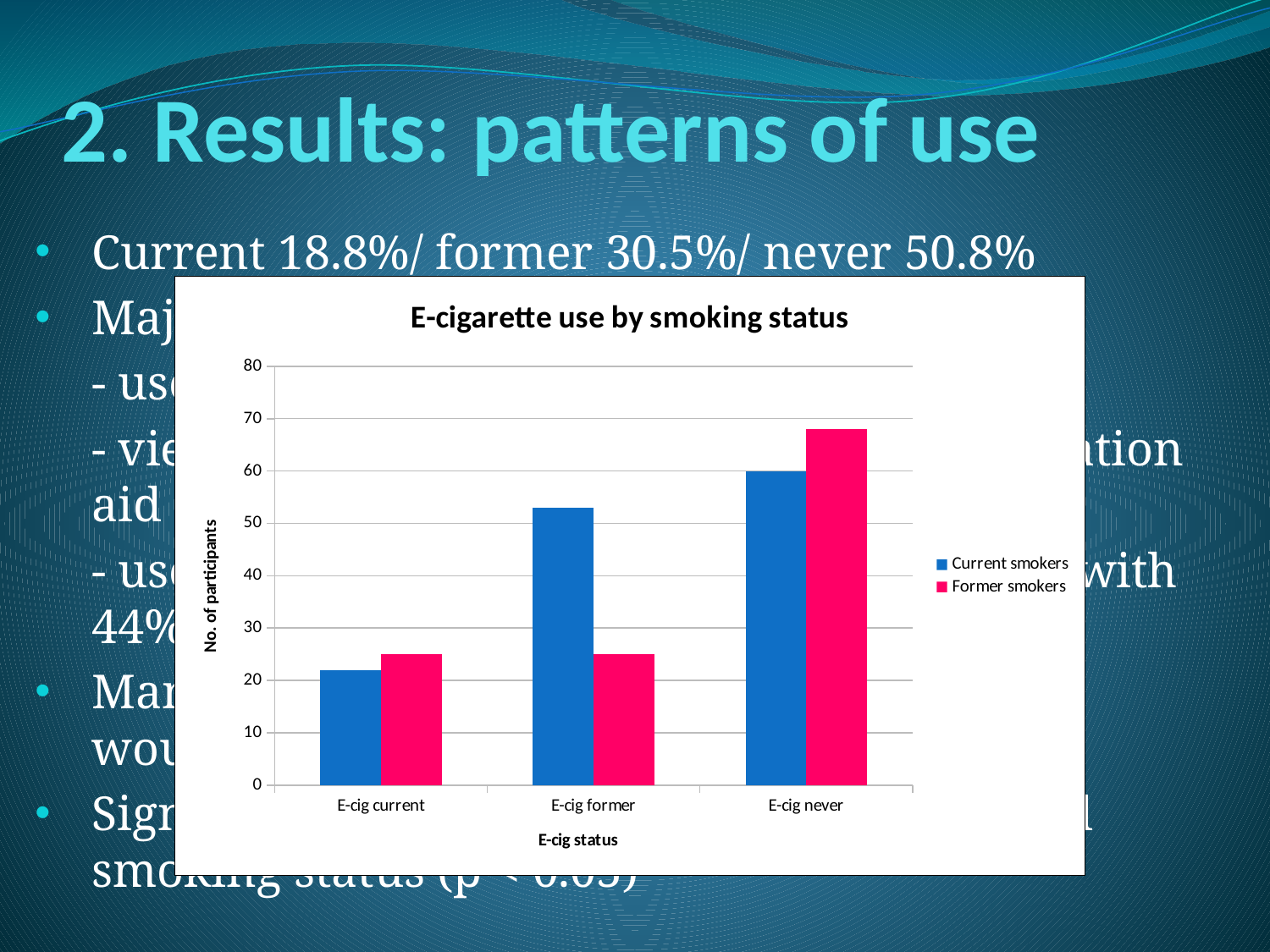
For which e-cig status is the Current smokers value lowest? E-cig current What is the label of the vertical axis? No. of participants What kind of chart is shown on the slide? bar chart How many e-cig status categories are shown on the x axis? 3 Is the Former smokers value for E-cig never greater or less than 60? greater Do the Current smokers values rise or fall from E-cig current to E-cig never? rise Is the Current smokers value for E-cig former greater or less than 50? greater How many series does the legend list? 2 For E-cig former, which series has the larger value, Current smokers or Former smokers? Current smokers For which e-cig status is the Former smokers value highest? E-cig never What is the title of the chart? E-cigarette use by smoking status Is the Former smokers value for E-cig former greater or less than 30? less